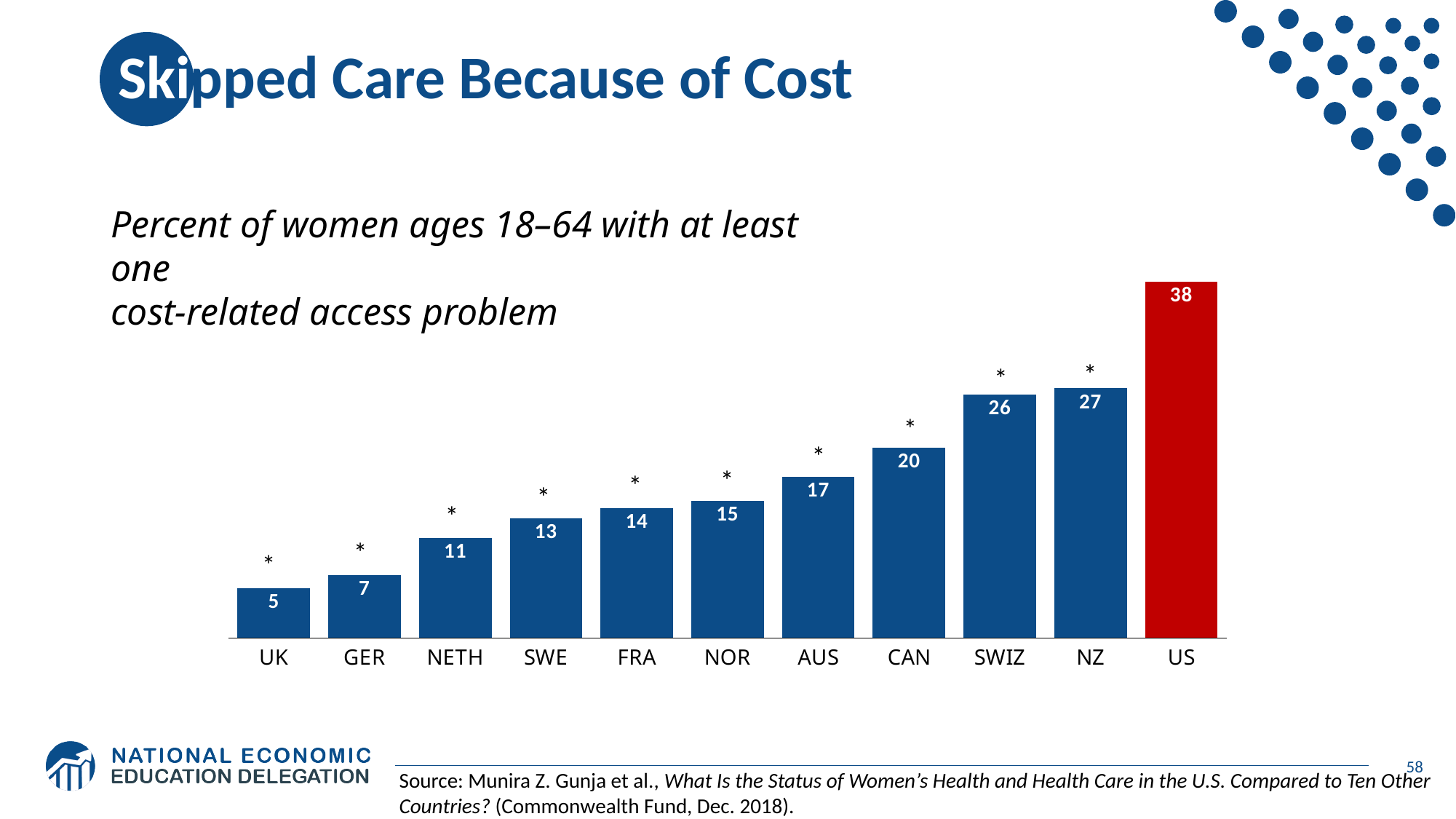
Which country has the lowest value? UK Which bar is coloured red rather than blue? US What is the value for the US? 38 Do the values rise or fall from left to right along the x axis? Rise Which country has the highest value? US What is the difference between the values for the US and NZ? 11 What is the difference between the values for SWIZ and NETH? 15 What is the value for Germany (GER)? 7 What kind of chart is shown on the slide? Bar chart What is the value for Canada (CAN)? 20 Which has a larger value, AUS or FRA? AUS How many countries are shown in the chart? 11